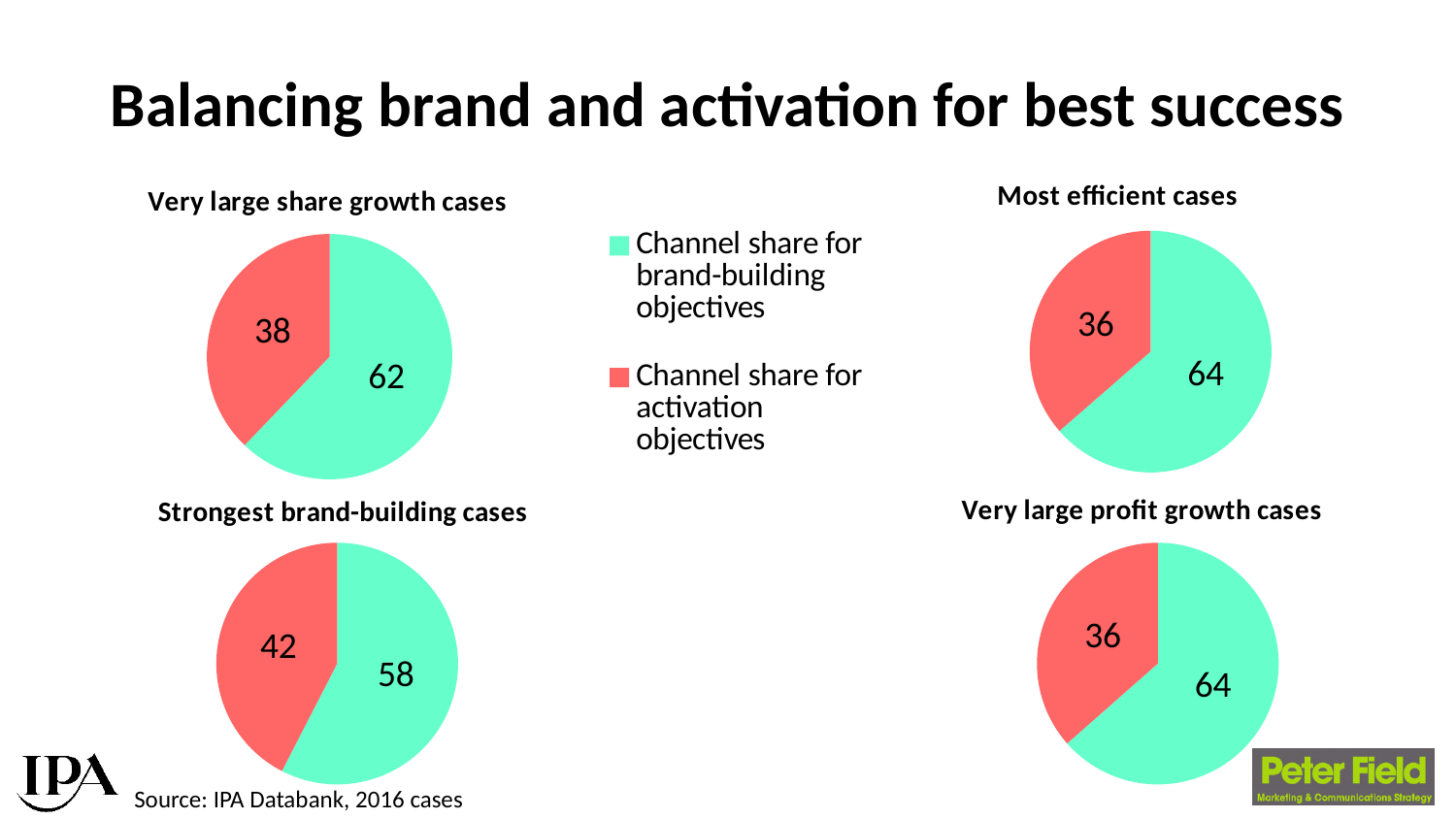
How many series does the legend list? 2 In the 'Most efficient cases' pie chart, what is the difference between the brand-building and activation values? 28 What kind of chart is used on this slide? Pie chart In the 'Strongest brand-building cases' pie chart, which slice is larger: brand-building objectives or activation objectives? Brand-building objectives What colour represents channel share for activation objectives in the legend? Red In the 'Very large profit growth cases' pie chart, what is the value for channel share for brand-building objectives? 64 In the 'Most efficient cases' pie chart, what is the value for channel share for activation objectives? 36 In the 'Very large share growth cases' pie chart, what is the value for channel share for brand-building objectives? 62 In the 'Strongest brand-building cases' pie chart, what is the difference between the brand-building and activation values? 16 How many pie charts are shown on the slide? 4 In the 'Very large share growth cases' pie chart, what is the value for channel share for activation objectives? 38 In the 'Strongest brand-building cases' pie chart, what is the value for channel share for brand-building objectives? 58